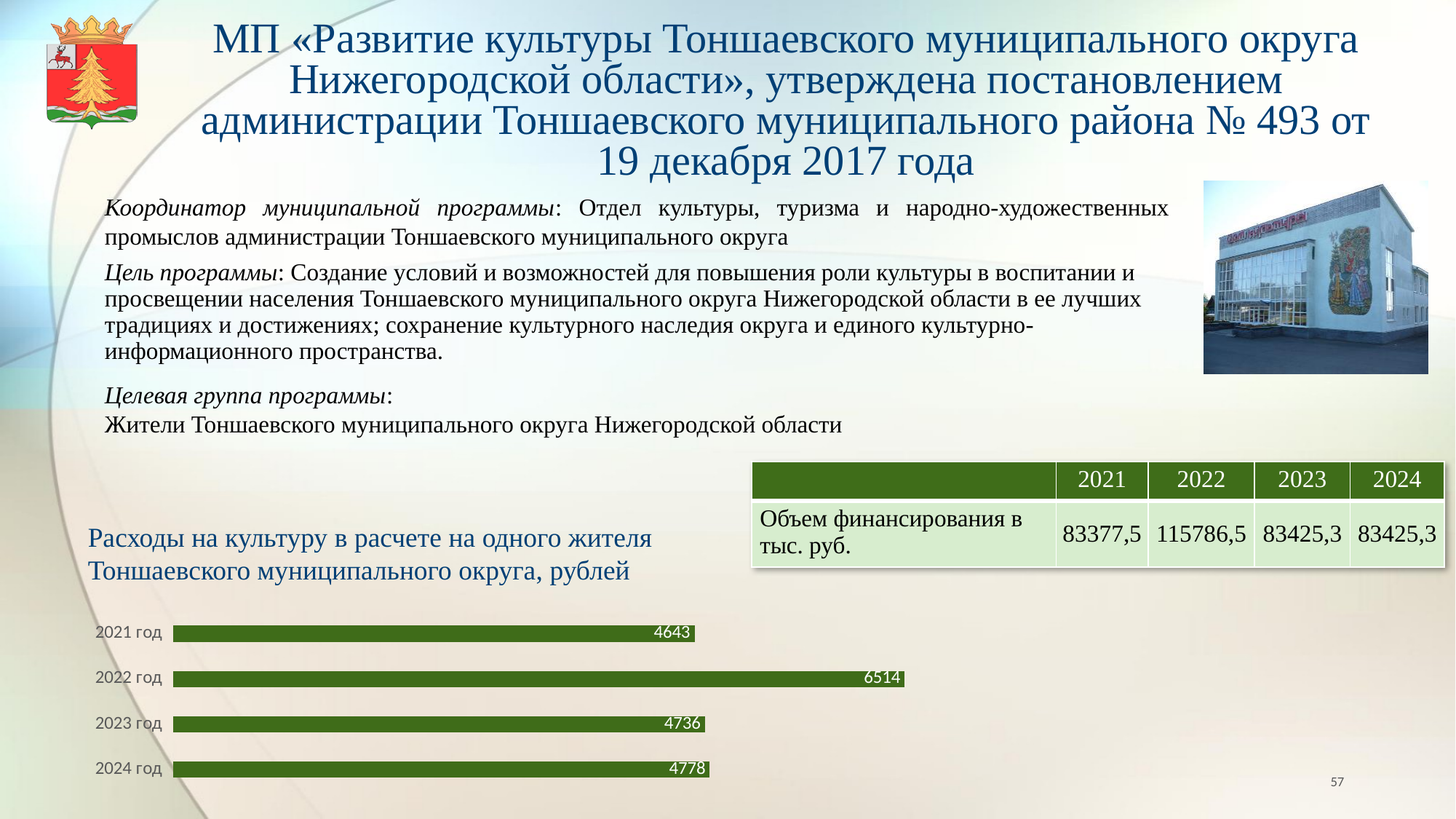
What is the value for 2022 год in the bar chart? 6514 What kind of chart is shown on the slide? Bar chart Which is larger in the bar chart, the value for 2022 год or the value for 2024 год? 2022 год How many categories (years) are shown in the bar chart? 4 What is the difference between the values for 2022 год and 2021 год in the bar chart? 1871 Which year has the lowest value in the bar chart? 2021 год What is the value for 2021 год in the bar chart? 4643 What is the value for 2024 год in the bar chart? 4778 What is the difference between the values for 2024 год and 2023 год in the bar chart? 42 What is the value for 2023 год in the bar chart? 4736 What colour are the bars in the chart? Green Which year has the highest value in the bar chart? 2022 год